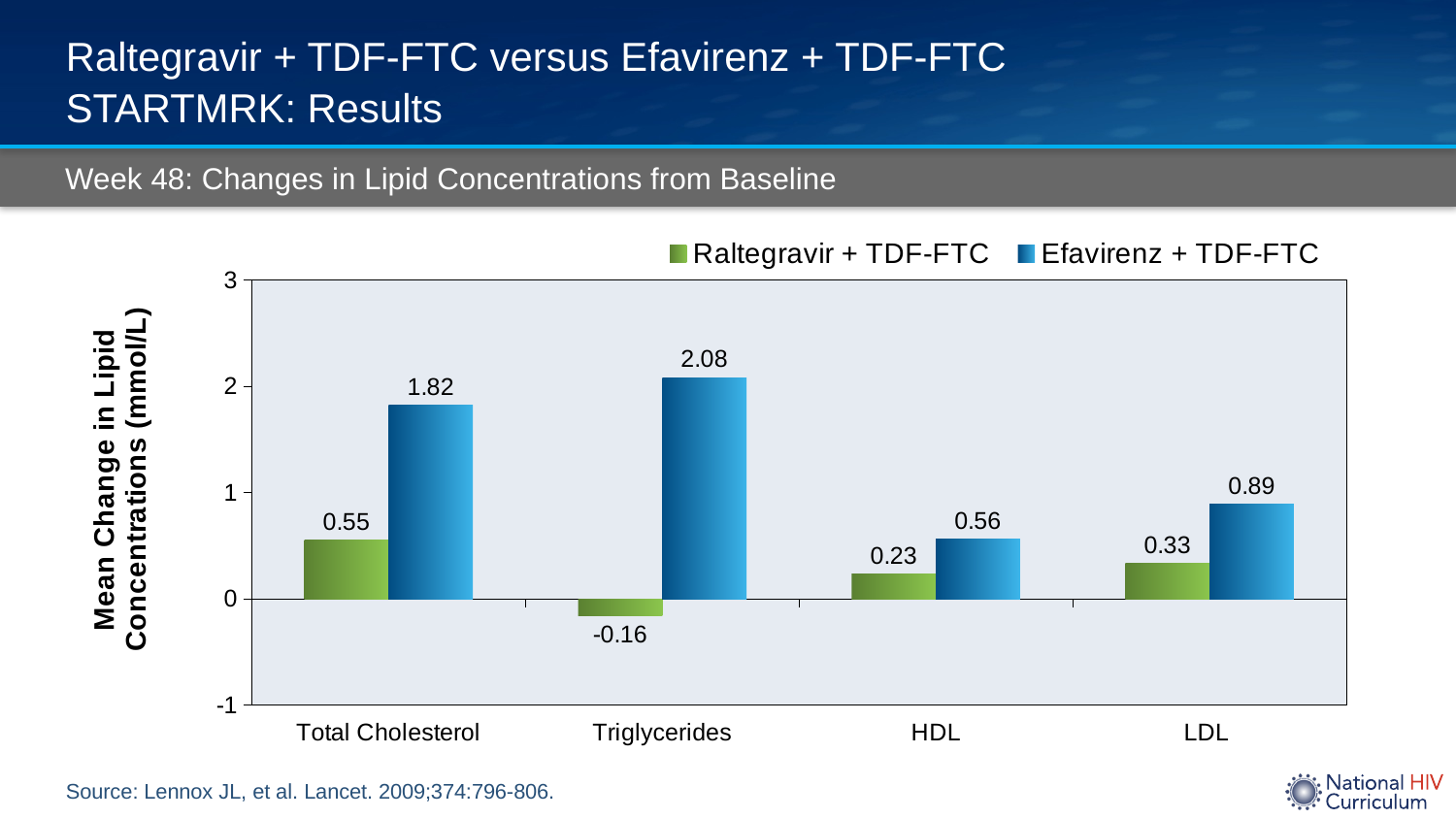
What kind of chart is shown on the slide? Bar chart What is the mean change in HDL for Raltegravir + TDF-FTC? 0.23 How many lipid categories are shown on the x axis? 4 What is the difference between the Efavirenz + TDF-FTC and Raltegravir + TDF-FTC values for total cholesterol? 1.27 What is the mean change in total cholesterol for Raltegravir + TDF-FTC? 0.55 What is the mean change in LDL for Efavirenz + TDF-FTC? 0.89 Which lipid category has the highest value for Efavirenz + TDF-FTC? Triglycerides How many series does the legend list? 2 Is the Efavirenz + TDF-FTC value for triglycerides greater or less than 2? greater What is the mean change in triglycerides for Efavirenz + TDF-FTC? 2.08 Which lipid category has the lowest value for Raltegravir + TDF-FTC? Triglycerides Which is larger for LDL: the Raltegravir + TDF-FTC value or the Efavirenz + TDF-FTC value? Efavirenz + TDF-FTC